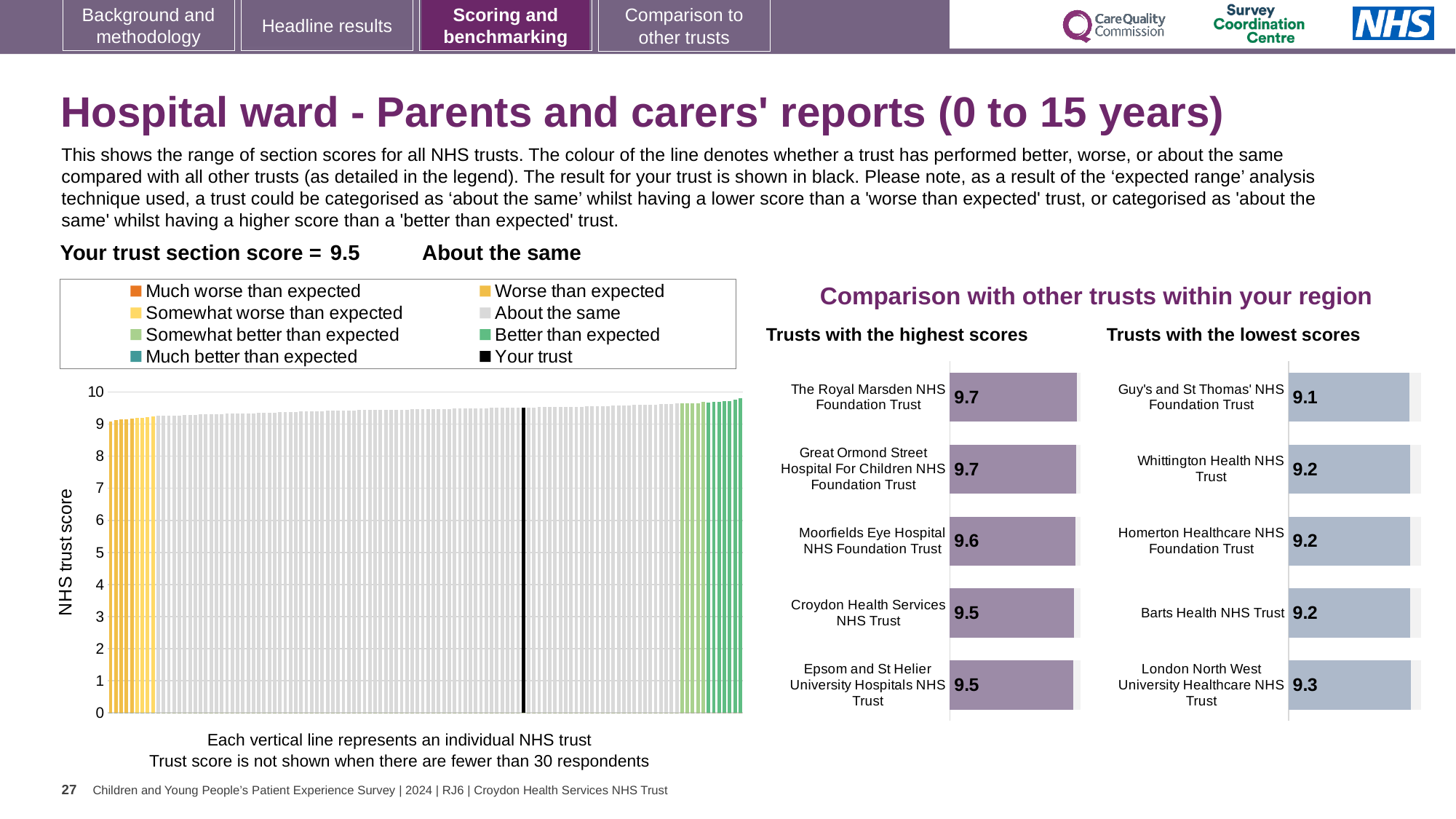
In the 'Trusts with the highest scores' chart, what is the difference between the score for The Royal Marsden NHS Foundation Trust and the score for Croydon Health Services NHS Trust? 0.2 In the large chart on the left, do the trust scores rise or fall from left to right along the x axis? Rise In the large chart on the left, is the value for the black 'Your trust' line greater or less than 9? greater How many trusts are listed in the 'Trusts with the highest scores' chart? 5 How many entries does the legend above the large chart on the left list? 8 In the 'Trusts with the lowest scores' chart, which trust has the lowest score? Guy's and St Thomas' NHS Foundation Trust What kind of chart is the large chart on the left showing NHS trust scores? Bar chart How many trusts are listed in the 'Trusts with the lowest scores' chart? 5 In the 'Trusts with the lowest scores' chart, what is the score for Guy's and St Thomas' NHS Foundation Trust? 9.1 In the 'Trusts with the highest scores' chart, what is the score for Moorfields Eye Hospital NHS Foundation Trust? 9.6 In the 'Trusts with the lowest scores' chart, what is the score for London North West University Healthcare NHS Trust? 9.3 Which is larger: the score for Moorfields Eye Hospital NHS Foundation Trust in the 'Trusts with the highest scores' chart, or the score for Barts Health NHS Trust in the 'Trusts with the lowest scores' chart? Moorfields Eye Hospital NHS Foundation Trust